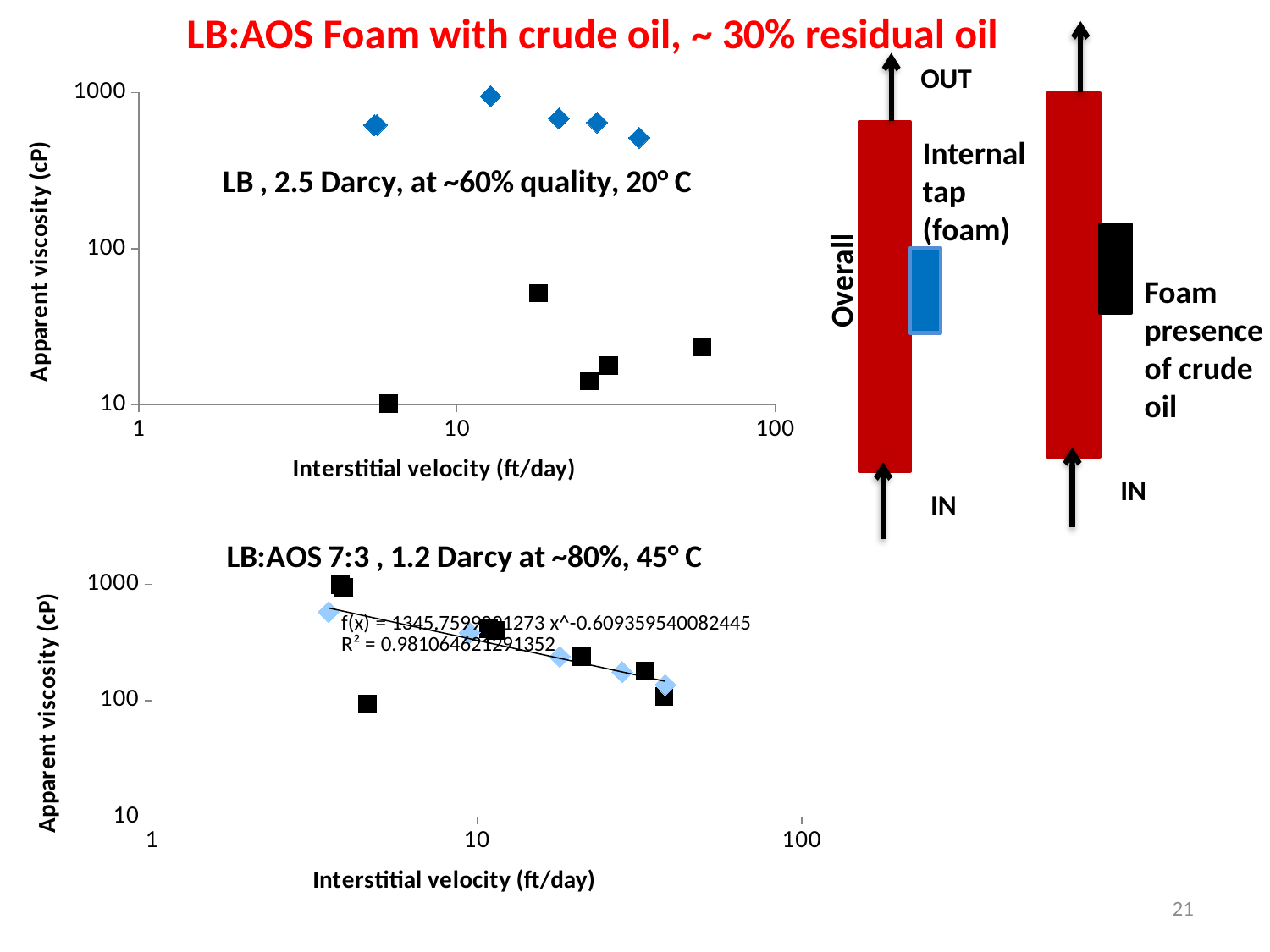
In the top chart, are the values of the black square points greater or less than 100? less In the top chart, what is the highest tick value shown on the y axis? 1000 In the bottom chart, what R² value is printed for the trend line? 0.981064621291352 In the bottom chart, what is the label of the x axis? Interstitial velocity (ft/day) In the top chart, what is the label of the y axis? Apparent viscosity (cP) In the bottom chart, do the values along the fitted trend line rise or fall as interstitial velocity increases? Fall What kind of chart is the bottom chart titled 'LB:AOS 7:3 , 1.2 Darcy at ~80%, 45° C'? Scatter chart In the top chart, which series has the higher apparent viscosity values, the blue diamonds or the black squares? Blue diamonds In the top chart, are the values of the blue diamond points greater or less than 100? greater What kind of chart is the top chart titled 'LB , 2.5 Darcy, at ~60% quality, 20° C'? Scatter chart